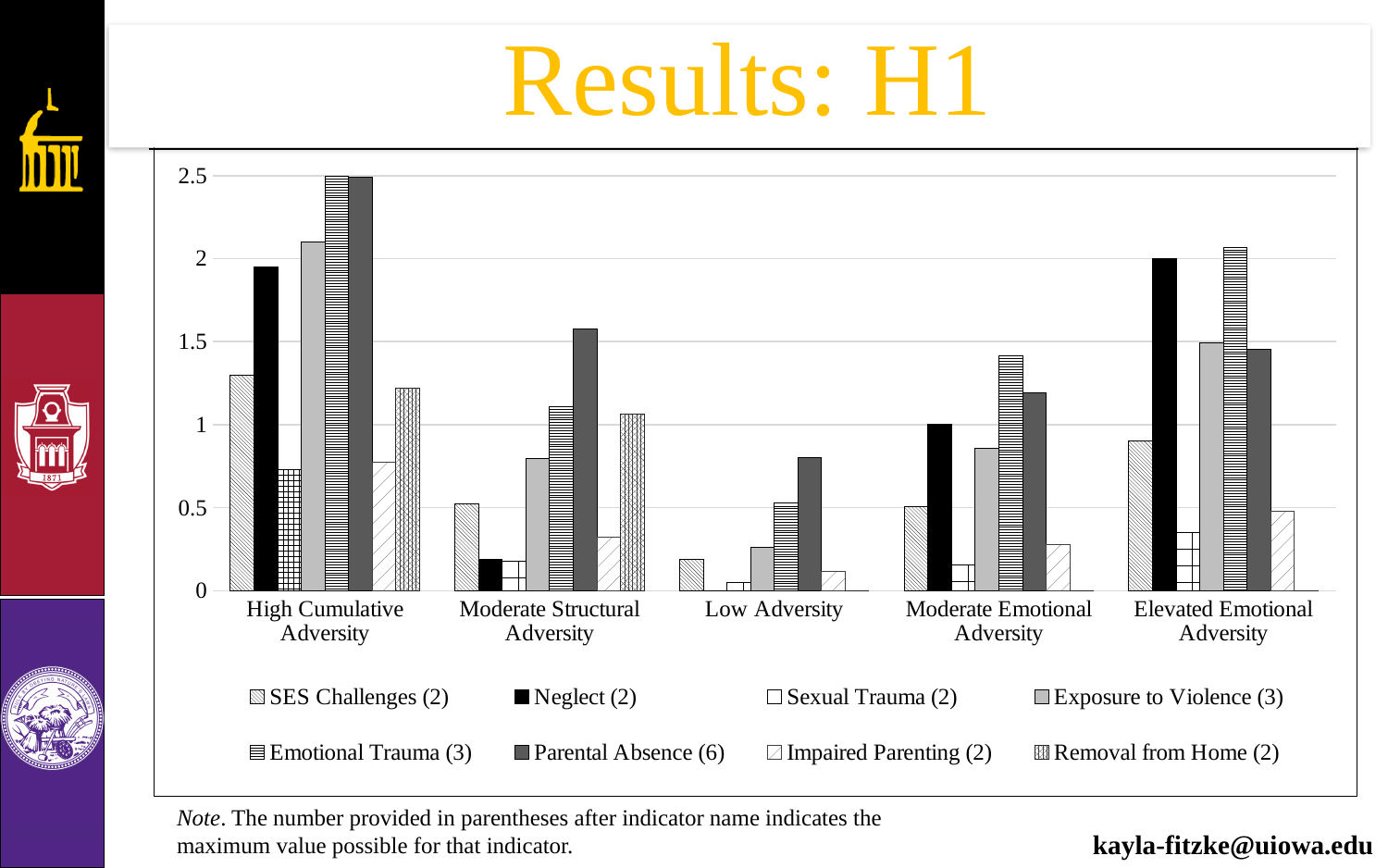
What kind of chart is shown on the slide? bar chart Is the value for Neglect in the High Cumulative Adversity group greater or less than 1.5? greater In the High Cumulative Adversity group, which is larger: Neglect or SES Challenges? Neglect According to the legend, what is the maximum possible value for the Parental Absence indicator? 6 Is the value for Emotional Trauma in the Elevated Emotional Adversity group greater or less than 1.5? greater Is the value for SES Challenges in the Moderate Structural Adversity group greater or less than 1? less How many adversity categories are shown along the x axis? 5 Within the Moderate Structural Adversity group, which indicator has the highest value? Parental Absence How many indicator series does the legend list? 8 Within the Low Adversity group, which indicator has the highest value? Parental Absence